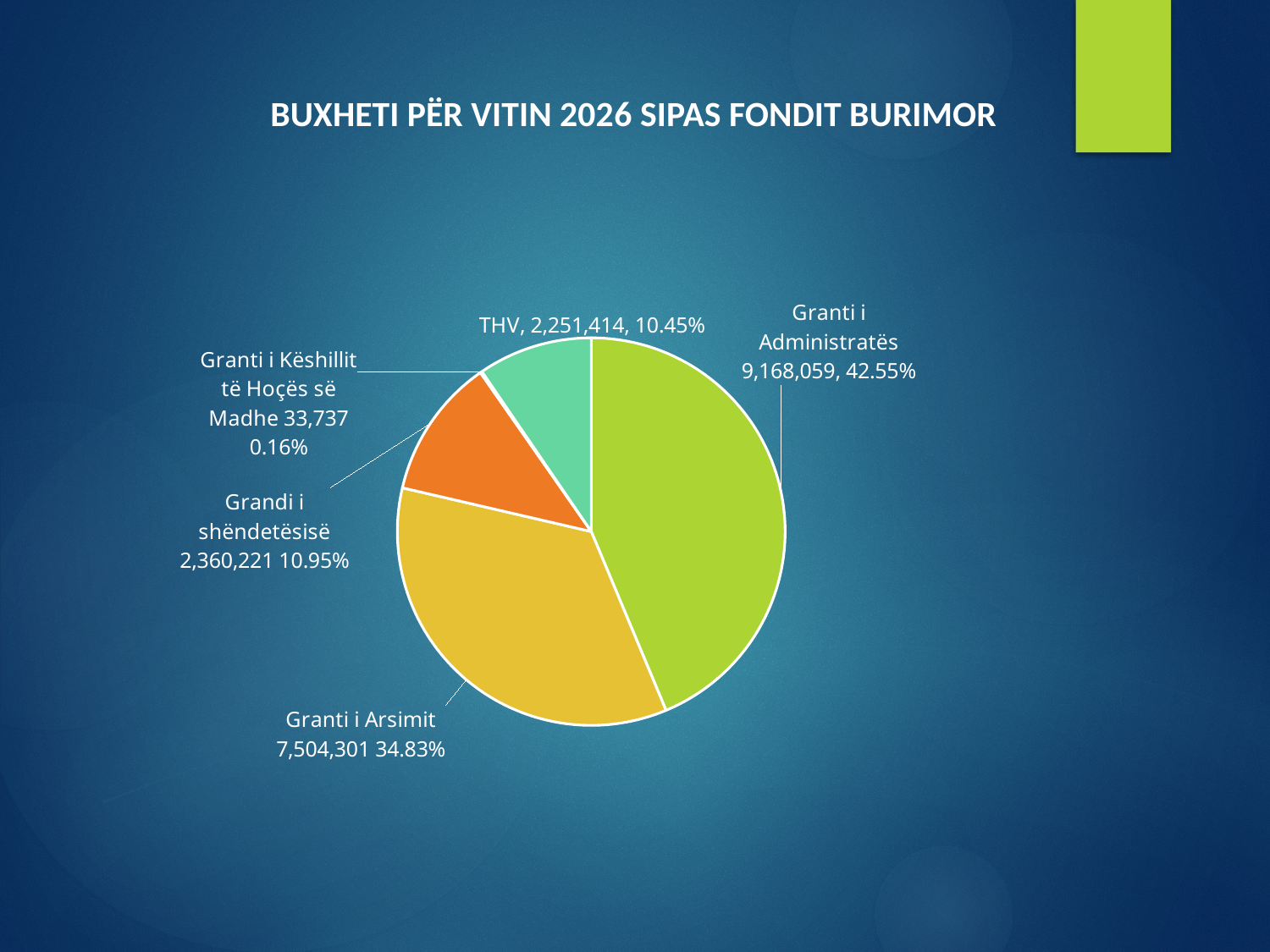
What is the value for Granti i Arsimit? 7,504,301 What is the difference between the values for Granti i Administratës and Granti i Arsimit? 1,663,758 What is the value for Granti i Administratës? 9,168,059 What share of the pie does Granti i Arsimit represent? 34.83% What kind of chart is shown on the slide? pie chart Which category has the largest slice? Granti i Administratës What is the value for Granti i Këshillit të Hoçës së Madhe? 33,737 Which category has the smallest slice? Granti i Këshillit të Hoçës së Madhe What is the title of the chart? BUXHETI PËR VITIN 2026 SIPAS FONDIT BURIMOR What is the value for THV? 2,251,414 What share of the pie does Grandi i shëndetësisë represent? 10.95% How many slices does the pie chart have? 5